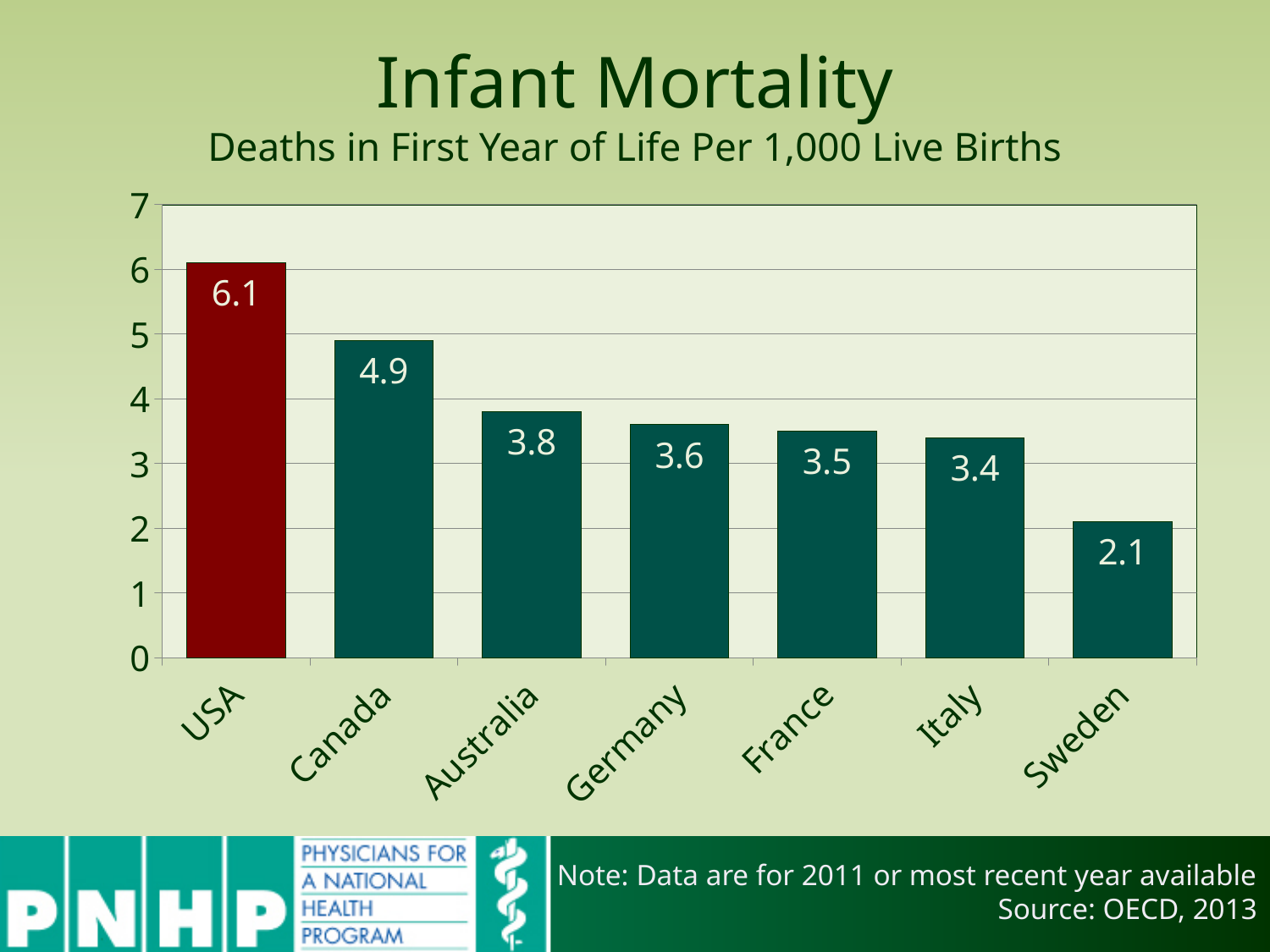
What is the difference between the infant mortality rates of the USA and Canada? 1.2 What is the infant mortality rate for Germany? 3.6 What type of chart is shown on the slide? Bar chart What is the infant mortality rate for Sweden? 2.1 What is the infant mortality rate for the USA? 6.1 What is the infant mortality rate for Canada? 4.9 Which country has the highest infant mortality rate? USA Which bar is coloured differently (dark red) from the others? USA Which country has the lowest infant mortality rate? Sweden Which has a higher infant mortality rate, Australia or Italy? Australia How many countries are shown in the chart? 7 What is the difference between the infant mortality rates of the USA and Sweden? 4.0